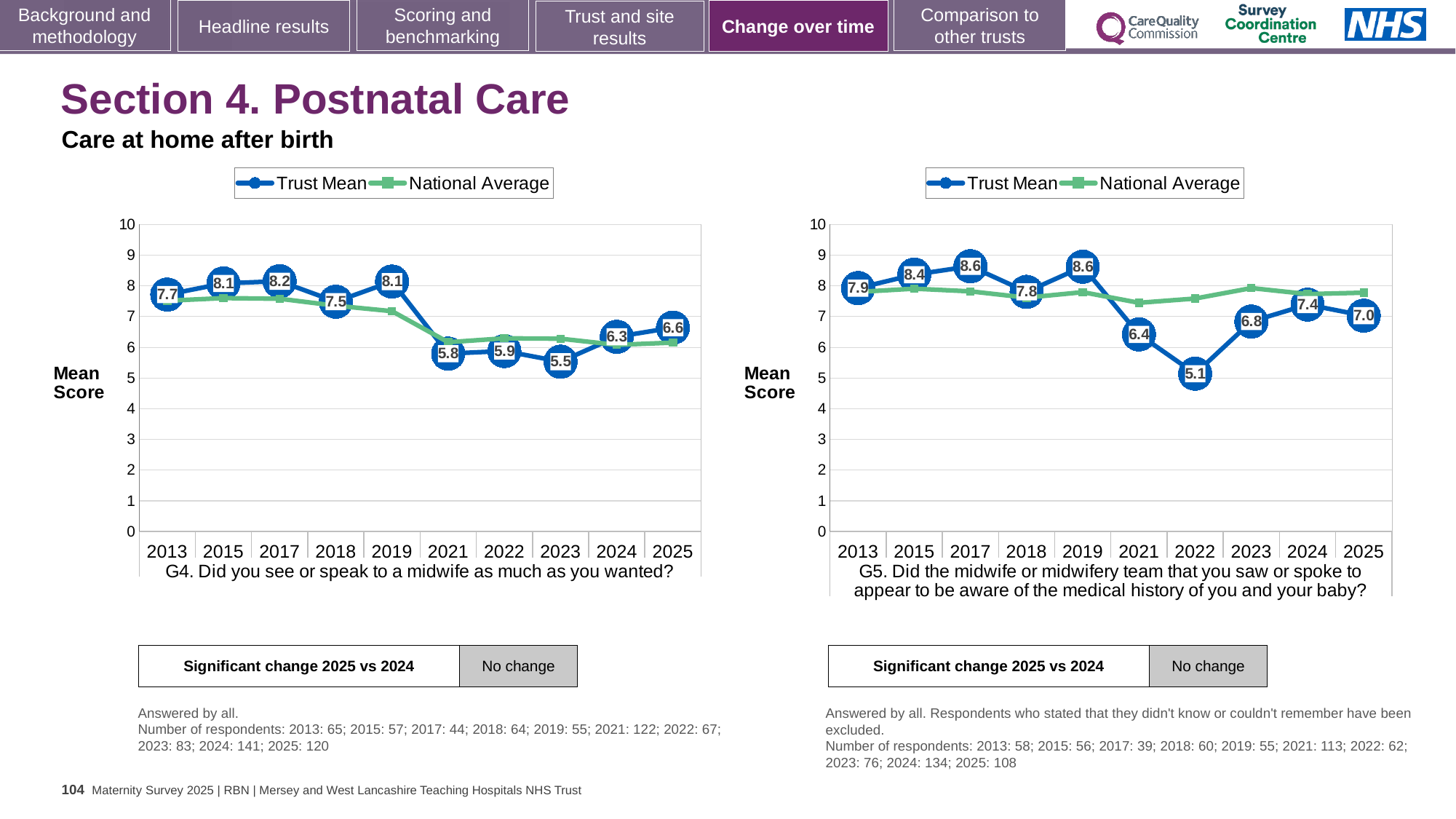
How many years are plotted on the x axis of the G4 chart on the left? 10 In the G4 chart on the left, is the Trust Mean for 2019 or for 2018 larger? 2019 How many series does the legend of the G5 chart on the right list? 2 In the G4 chart on the left, which year has the highest Trust Mean? 2017 In the G5 chart on the right, what is the difference between the Trust Mean for 2019 and the Trust Mean for 2021? 2.2 In the G4 chart on the left, what is the Trust Mean for 2025? 6.6 In the G5 chart on the right, which year has the lowest Trust Mean? 2022 In the G5 chart on the right, what is the Trust Mean for 2022? 5.1 What kind of chart is the G4 chart on the left? Line chart In the G5 chart on the right, does the Trust Mean rise or fall from 2024 to 2025? Fall In the G5 chart on the right, is the National Average for 2022 greater or less than 7? greater In the G4 chart on the left, which year has the lowest Trust Mean? 2023